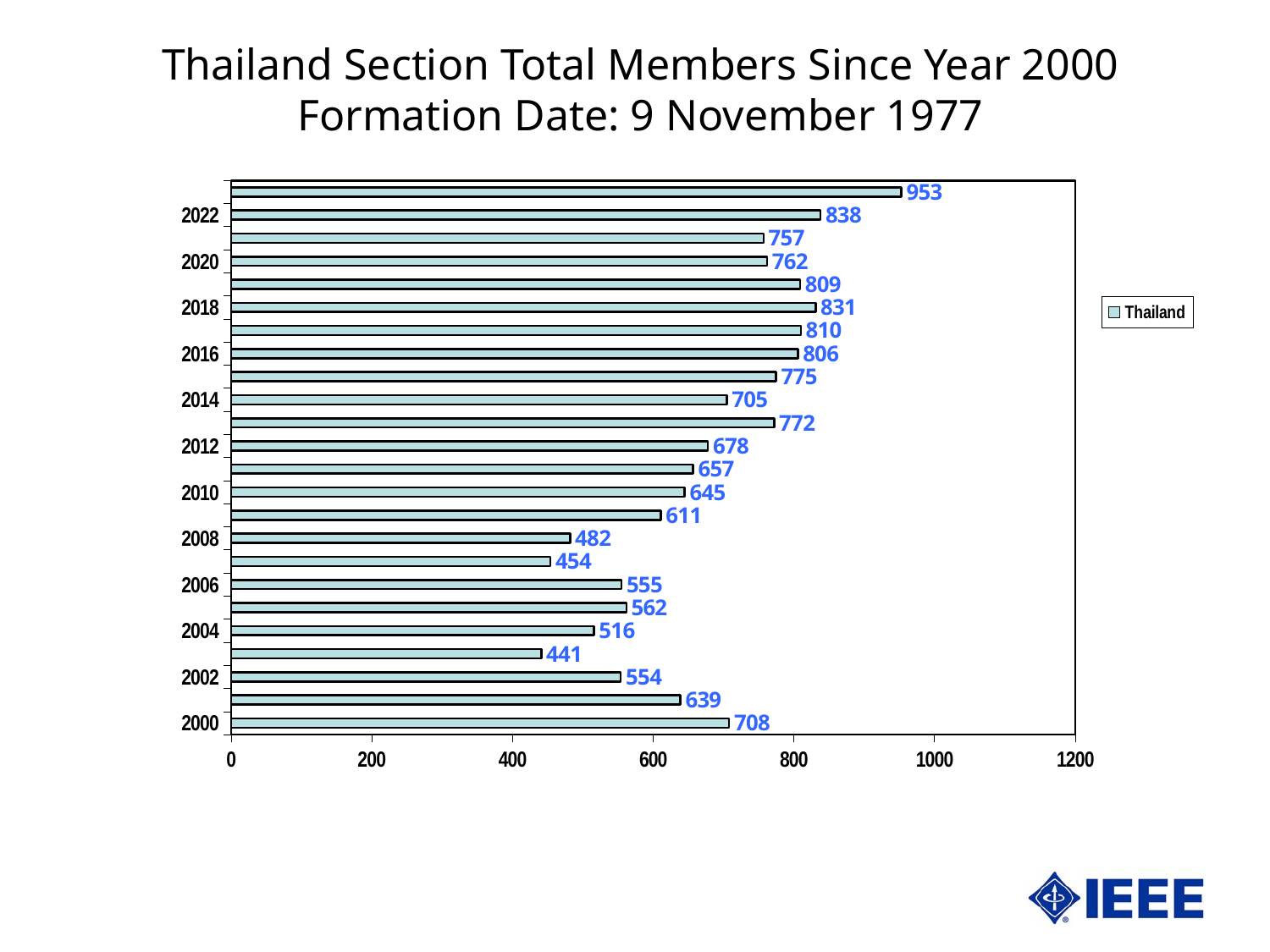
Is the value for 2014 greater or less than 800? less How many series does the legend list? 1 Which has the larger value, 2010 or 2006? 2010 What is the value for 2000? 708 What is the value for 2018? 831 How many bars are plotted on the chart? 24 What is the value for 2008? 482 What is the difference between the values for 2022 and 2020? 76 What kind of chart is shown? bar chart What is the lowest value shown on the chart? 441 What is the highest value shown on the chart? 953 What is the value for 2022? 838